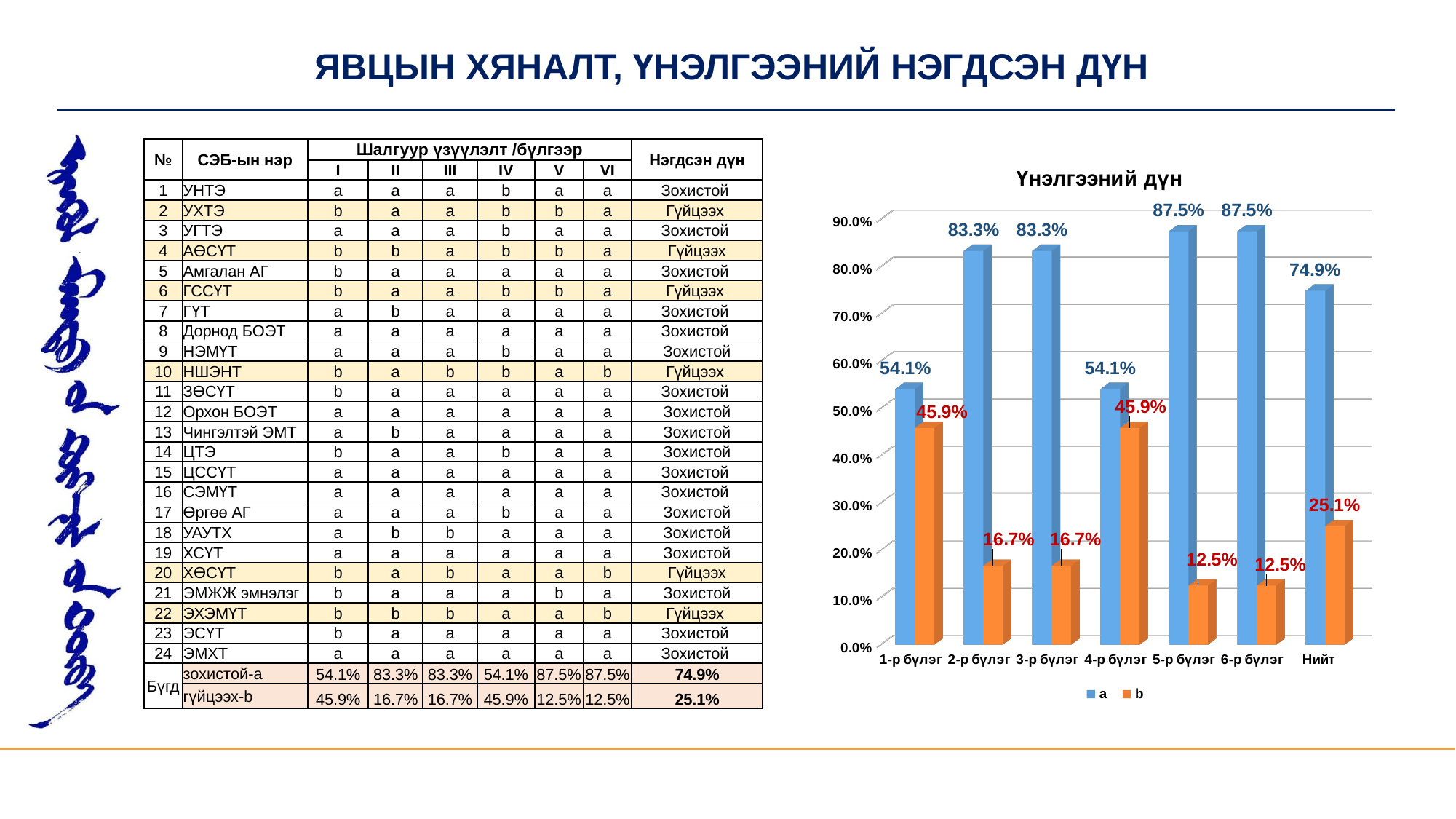
What is the difference between series a and series b for 3-р бүлэг? 66.6% What is the value of series a for Нийт in the chart? 74.9% Which is larger for 4-р бүлэг: series a or series b? series a Which category has the lowest value for series b in the chart? 5-р бүлэг and 6-р бүлэг (12.5%) Which category has the highest value for series b in the chart? 1-р бүлэг and 4-р бүлэг (45.9%) How many series does the chart legend list? 2 What is the value of series b for 5-р бүлэг in the chart? 12.5% What is the value of series b for 1-р бүлэг in the chart? 45.9% What is the value of series a for 2-р бүлэг in the chart? 83.3% Is the value of series a for 1-р бүлэг greater or less than 50.0%? greater What is the title of the chart? Үнэлгээний дүн How many categories are shown on the x axis of the chart? 7